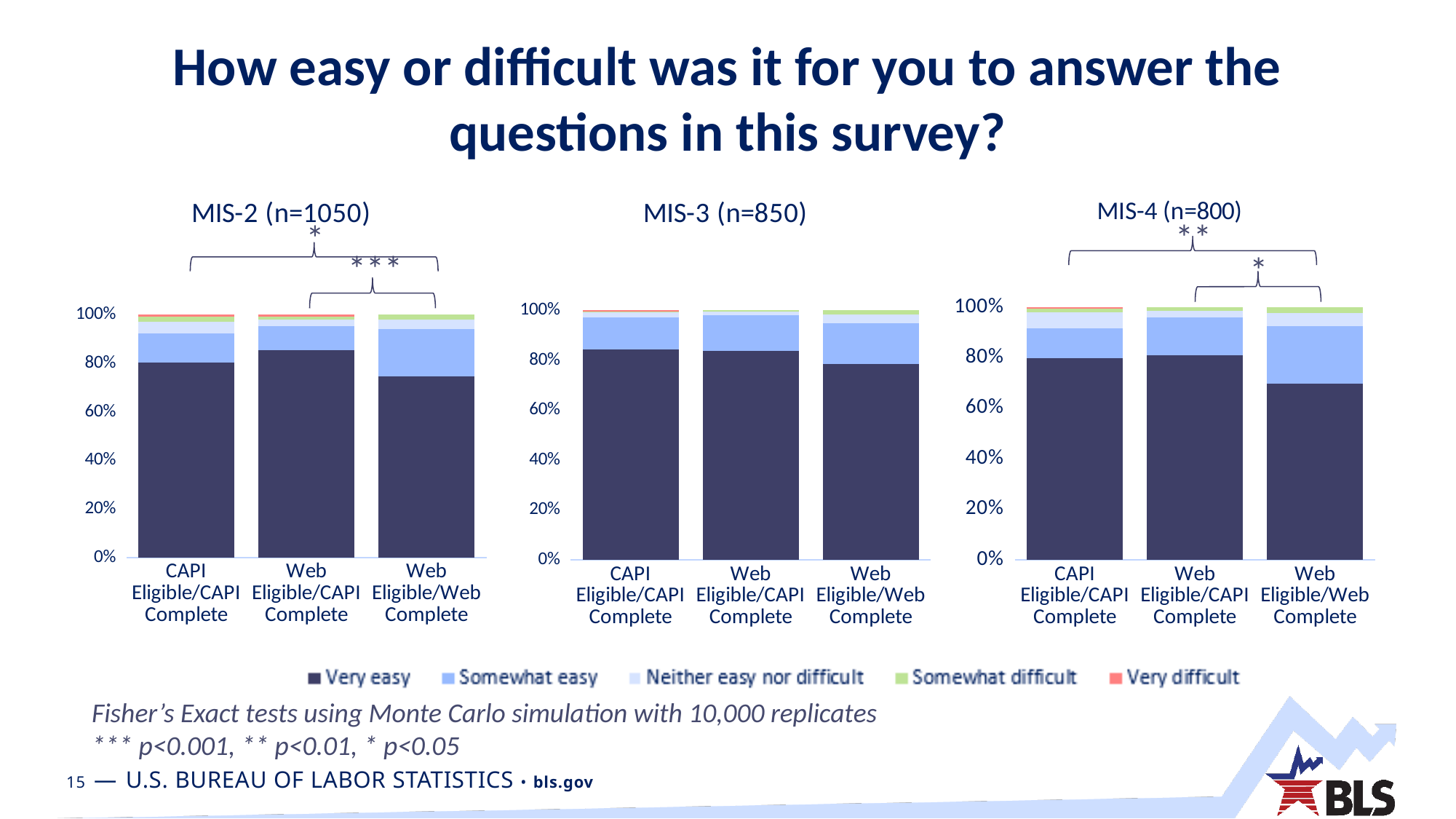
In the MIS-2 (n=1050) chart, is the Very easy share for Web Eligible/Web Complete greater or less than 80%? less In the MIS-2 (n=1050) chart, which category has the largest Very easy share? Web Eligible/CAPI Complete In the MIS-3 (n=850) chart, is the Very easy share for CAPI Eligible/CAPI Complete greater or less than 80%? greater In the MIS-2 (n=1050) chart, is the Very easy share for Web Eligible/CAPI Complete greater or less than 80%? greater How many series does the legend list? 5 How many categories are shown on the x axis of the MIS-3 (n=850) chart? 3 What is the total each stacked bar reaches in the MIS-3 (n=850) chart? 100% In the MIS-4 (n=800) chart, which category has the smallest Very easy share? Web Eligible/Web Complete In the MIS-4 (n=800) chart, which has the larger Very easy share: CAPI Eligible/CAPI Complete or Web Eligible/Web Complete? CAPI Eligible/CAPI Complete Which legend entry is shown in red? Very difficult What kind of chart is used for MIS-2 (n=1050)? Stacked bar chart